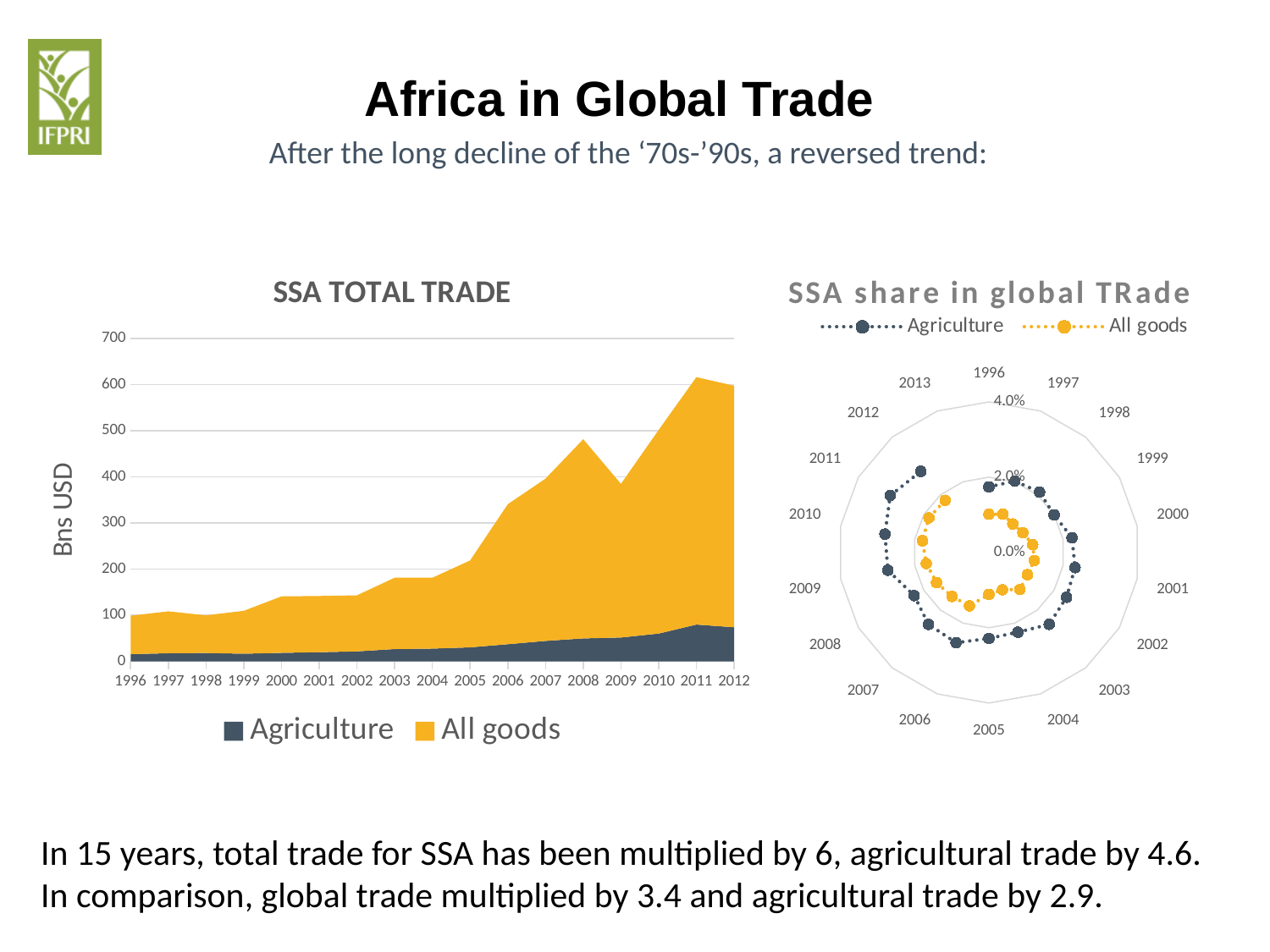
In the SSA TOTAL TRADE chart, does total trade generally rise or fall from 1996 to 2012? Rise How many years are plotted around the SSA share in global TRade radar chart? 18 What kind of chart is the SSA share in global TRade chart on the right? Radar chart What unit is shown on the y axis of the SSA TOTAL TRADE chart? Bns USD In the SSA TOTAL TRADE chart, is the total trade in 2011 greater or less than 600? greater How many series does the legend of the SSA TOTAL TRADE chart list? 2 What kind of chart is the SSA TOTAL TRADE chart on the left? Stacked area chart In the SSA TOTAL TRADE chart, is the Agriculture value in 2011 greater or less than 100? less In the SSA TOTAL TRADE chart, is the total trade in 2009 greater or less than 400? less How many years are shown on the x axis of the SSA TOTAL TRADE chart? 17 In the SSA TOTAL TRADE chart, which series has the larger value in 2012, Agriculture or All goods? All goods In the SSA TOTAL TRADE chart, which year has the highest total trade? 2011